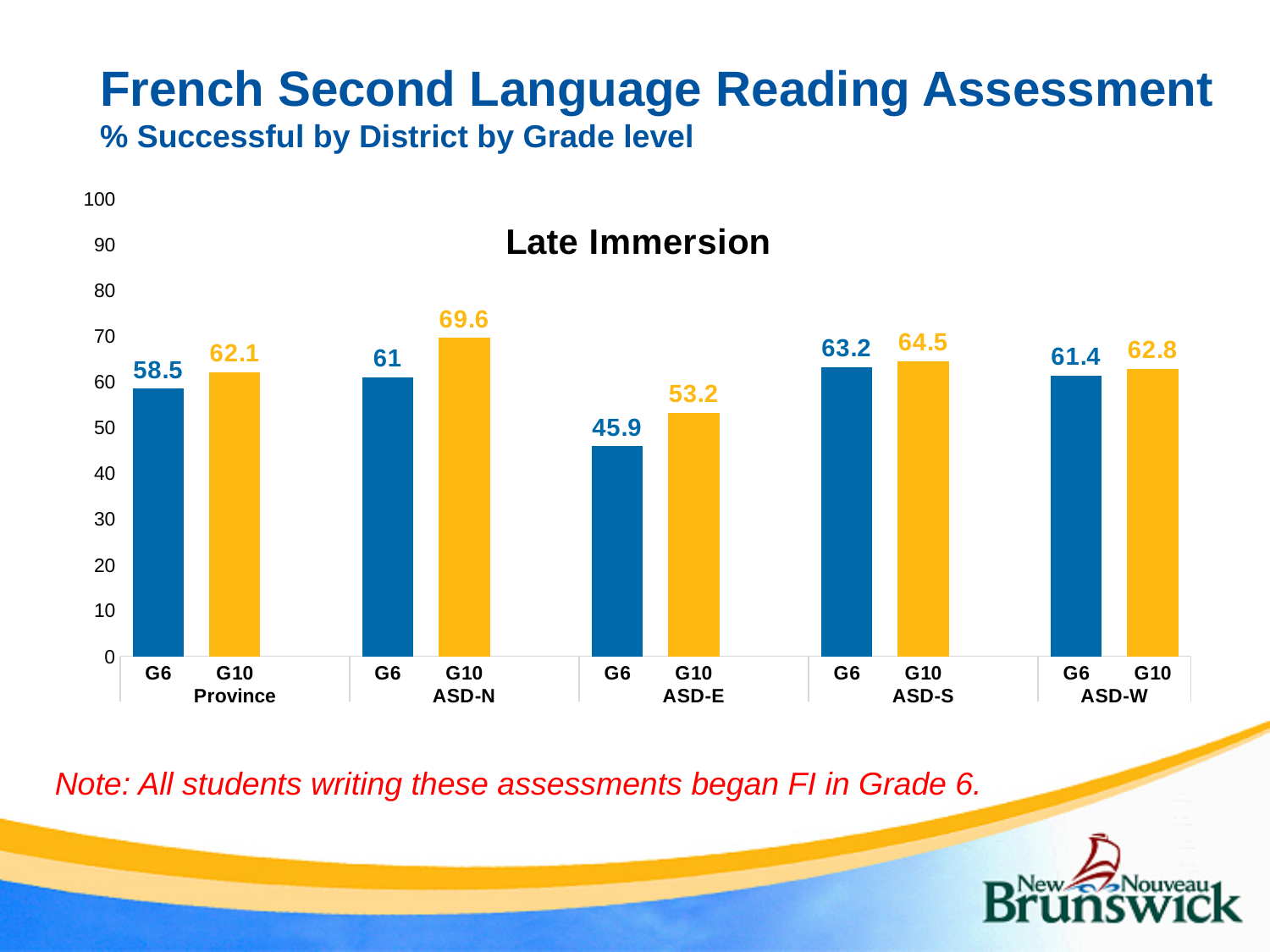
What is the G6 value for the Province? 58.5 What type of chart is shown on the slide? bar chart Which district has the highest G10 value? ASD-N Is the G6 value for ASD-E greater or less than 50? less What is the G6 value for ASD-E? 45.9 What is the difference between the G10 and G6 values for ASD-E? 7.3 What is the title shown inside the chart area? Late Immersion Which is larger, the G6 value for ASD-S or the G6 value for ASD-W? ASD-S How many districts (including Province) are shown on the chart? 5 What is the G10 value for ASD-W? 62.8 Which district has the lowest G6 value? ASD-E What is the G10 value for ASD-N? 69.6